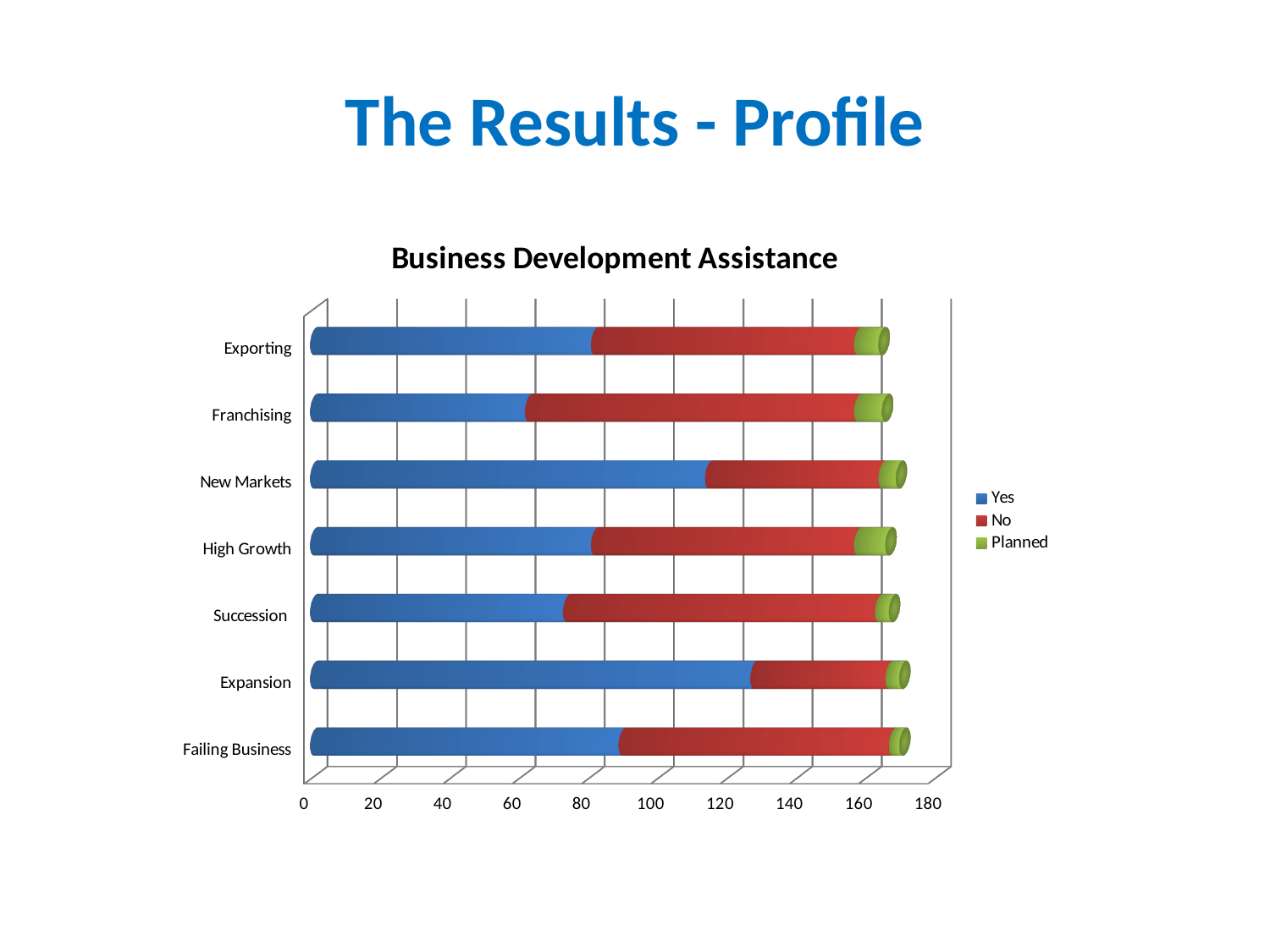
Which colour represents the Planned series in the legend? green Is the Yes value for Exporting greater or less than 100? less How many categories are shown on the chart? 7 Which category has the lowest value for the Yes series? Franchising Is the Yes value for New Markets greater or less than 100? greater What kind of chart is shown on the slide? bar chart How many series does the legend list? 3 What is the title of the chart? Business Development Assistance Which category has the highest value for the Yes series? Expansion Which has a larger Yes value, New Markets or Franchising? New Markets Is the Yes value for Expansion greater or less than 100? greater